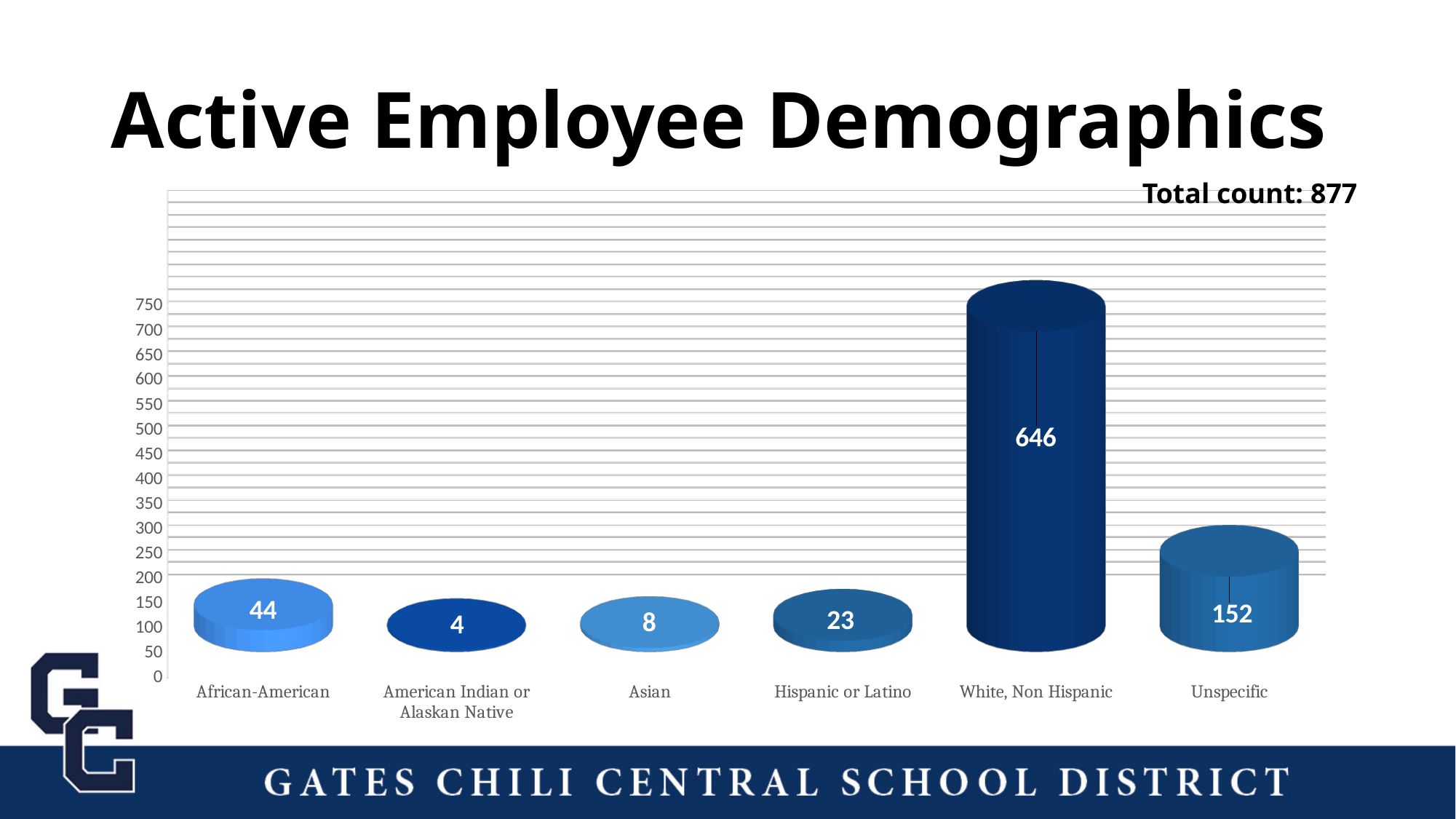
What total count is stated on the slide? 877 What kind of chart is shown on the slide? Bar chart What is the difference between the values for White, Non Hispanic and Unspecific? 494 What is the difference between the values for African-American and Asian? 36 What is the value for American Indian or Alaskan Native? 4 Which category has the lowest value? American Indian or Alaskan Native Which is larger, the value for African-American or the value for Hispanic or Latino? African-American What is the value for Unspecific? 152 What is the value for Hispanic or Latino? 23 How many categories are shown on the chart? 6 Which category has the highest value? White, Non Hispanic What is the value for White, Non Hispanic? 646